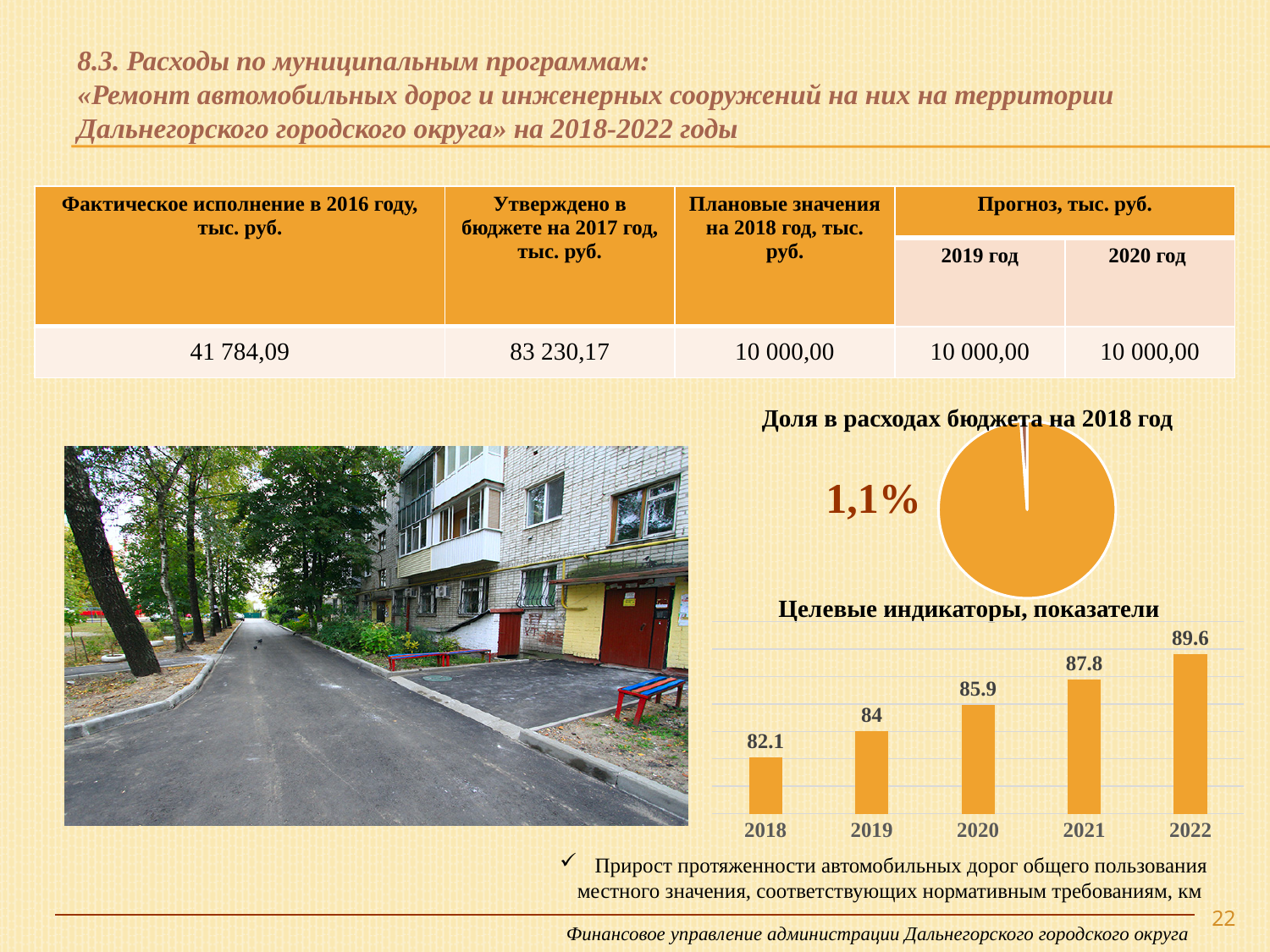
In the bar chart 'Целевые индикаторы, показатели', do the values rise or fall from 2018 to 2022? rise In the pie chart 'Доля в расходах бюджета на 2018 год', what share is labelled for the programme? 1,1% In the bar chart 'Целевые индикаторы, показатели', what is the difference between the values for 2021 and 2019? 3.8 What kind of chart is 'Целевые индикаторы, показатели'? bar chart How many years are shown in the bar chart 'Целевые индикаторы, показатели'? 5 In the bar chart 'Целевые индикаторы, показатели', what is the value for 2018? 82.1 In the bar chart 'Целевые индикаторы, показатели', what is the value for 2020? 85.9 In the bar chart 'Целевые индикаторы, показатели', what is the difference between the values for 2022 and 2018? 7.5 In the bar chart 'Целевые индикаторы, показатели', which year has the highest value? 2022 In the bar chart 'Целевые индикаторы, показатели', which year has the lowest value? 2018 In the bar chart 'Целевые индикаторы, показатели', which is larger, the value for 2019 or the value for 2021? 2021 In the bar chart 'Целевые индикаторы, показатели', what is the value for 2022? 89.6